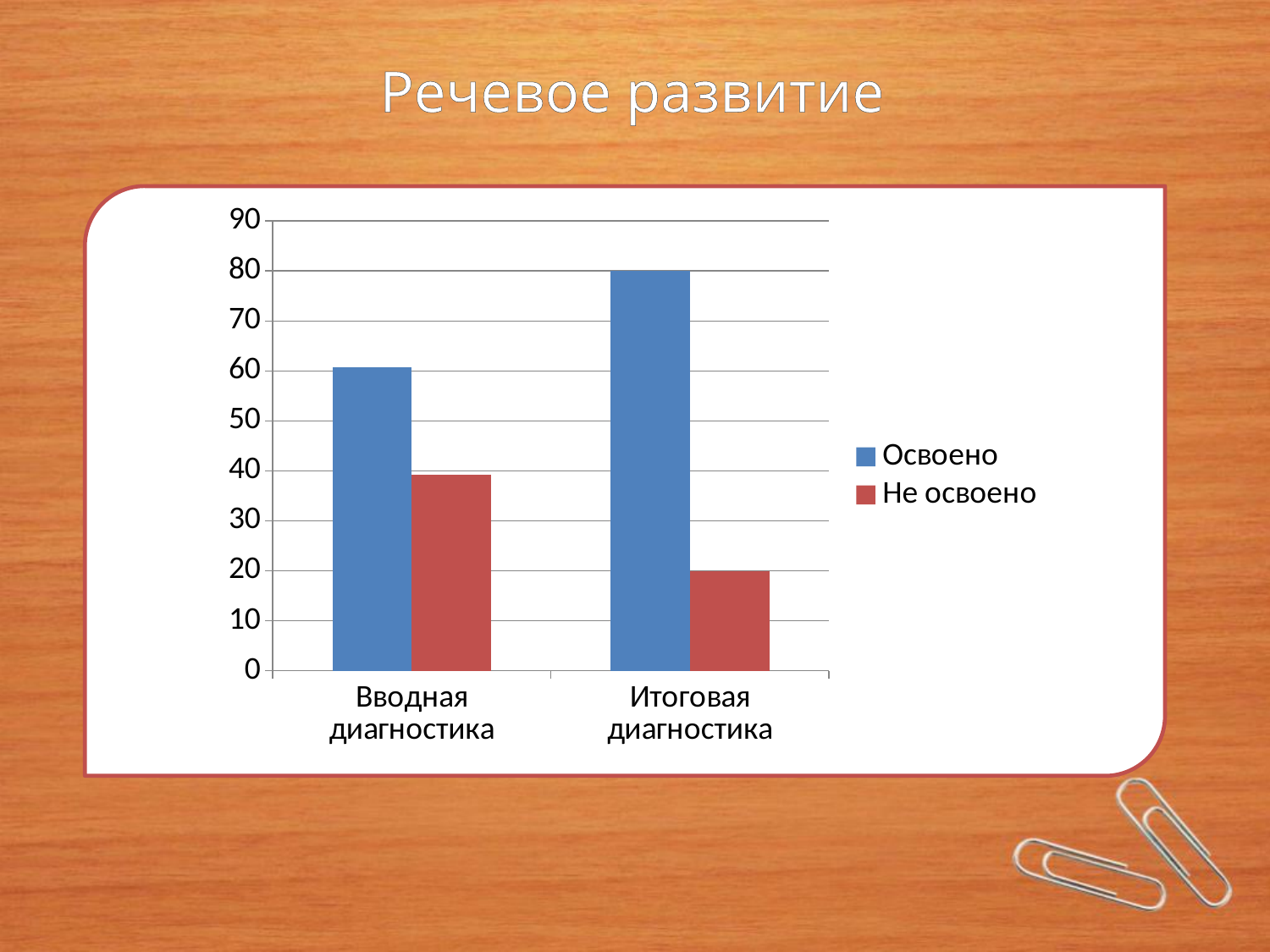
Which category has the highest Освоено value? Итоговая диагностика How many categories are shown on the x axis? 2 Is the value of Не освоено for Вводная диагностика greater or less than 50? less How many series does the legend list? 2 Which category has the lowest Не освоено value? Итоговая диагностика What kind of chart is shown on the slide? bar chart Does the Освоено value rise or fall from Вводная диагностика to Итоговая диагностика? rise What is the title of the slide? Речевое развитие Which is larger for Вводная диагностика: Освоено or Не освоено? Освоено Is the value of Освоено for Вводная диагностика greater or less than 50? greater